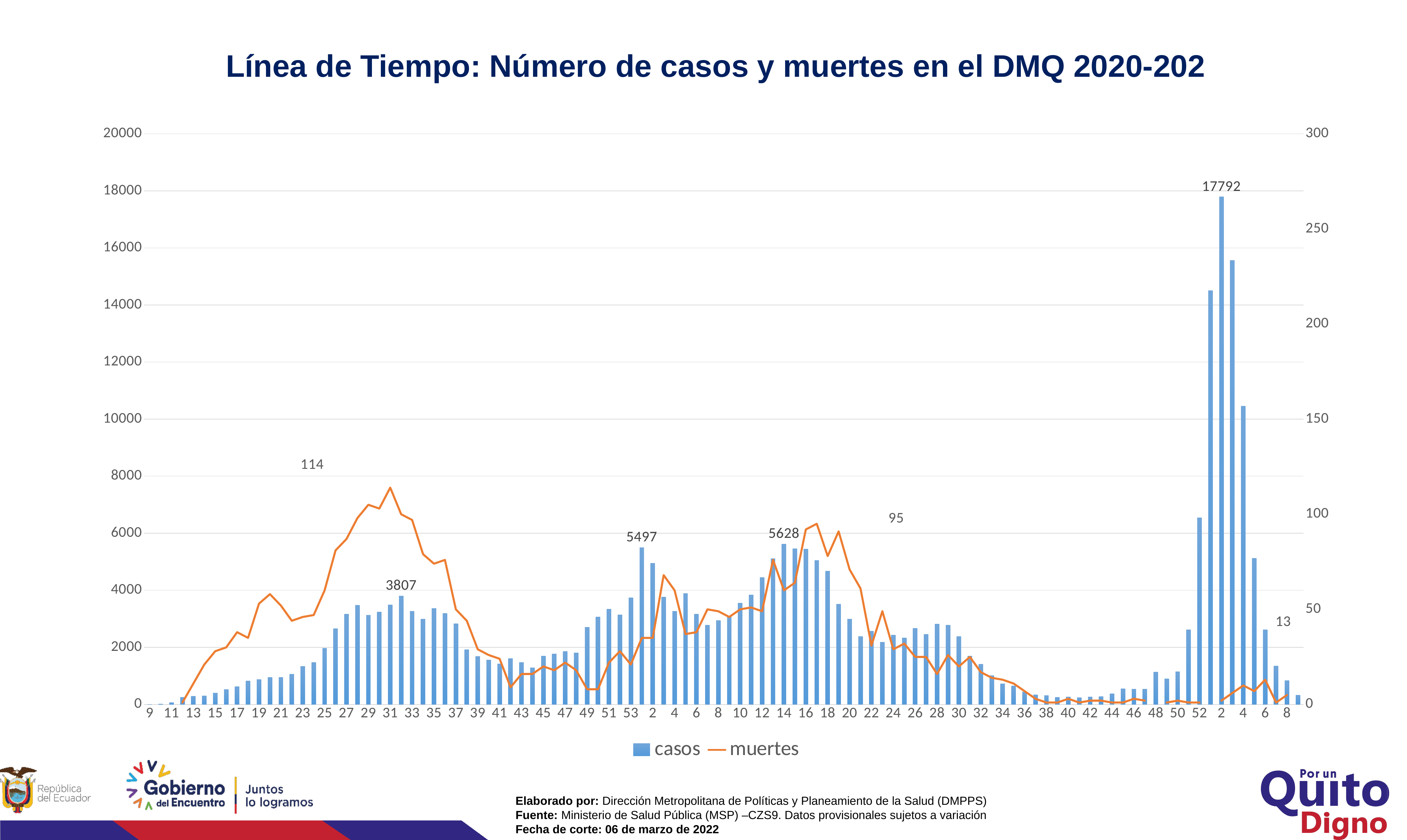
Is the tallest casos bar greater or less than 16000? greater Is the peak of the muertes line greater or less than 100 on the right axis? greater What kind of chart is shown on the slide? Combined bar and line chart What is the highest value labelled on the casos bars? 17792 Which series is drawn as an orange line? muertes How many series does the legend list? 2 Which is larger, the muertes label 114 or the muertes label 95? 114 What is the lowest value labelled on the muertes line? 13 What is the difference between the highest casos label (17792) and the casos label 5628? 12164 What is the difference between the casos labels 5628 and 5497? 131 Which is larger, the casos label 3807 or the casos label 5497? 5497 What is the highest value labelled on the muertes line? 114